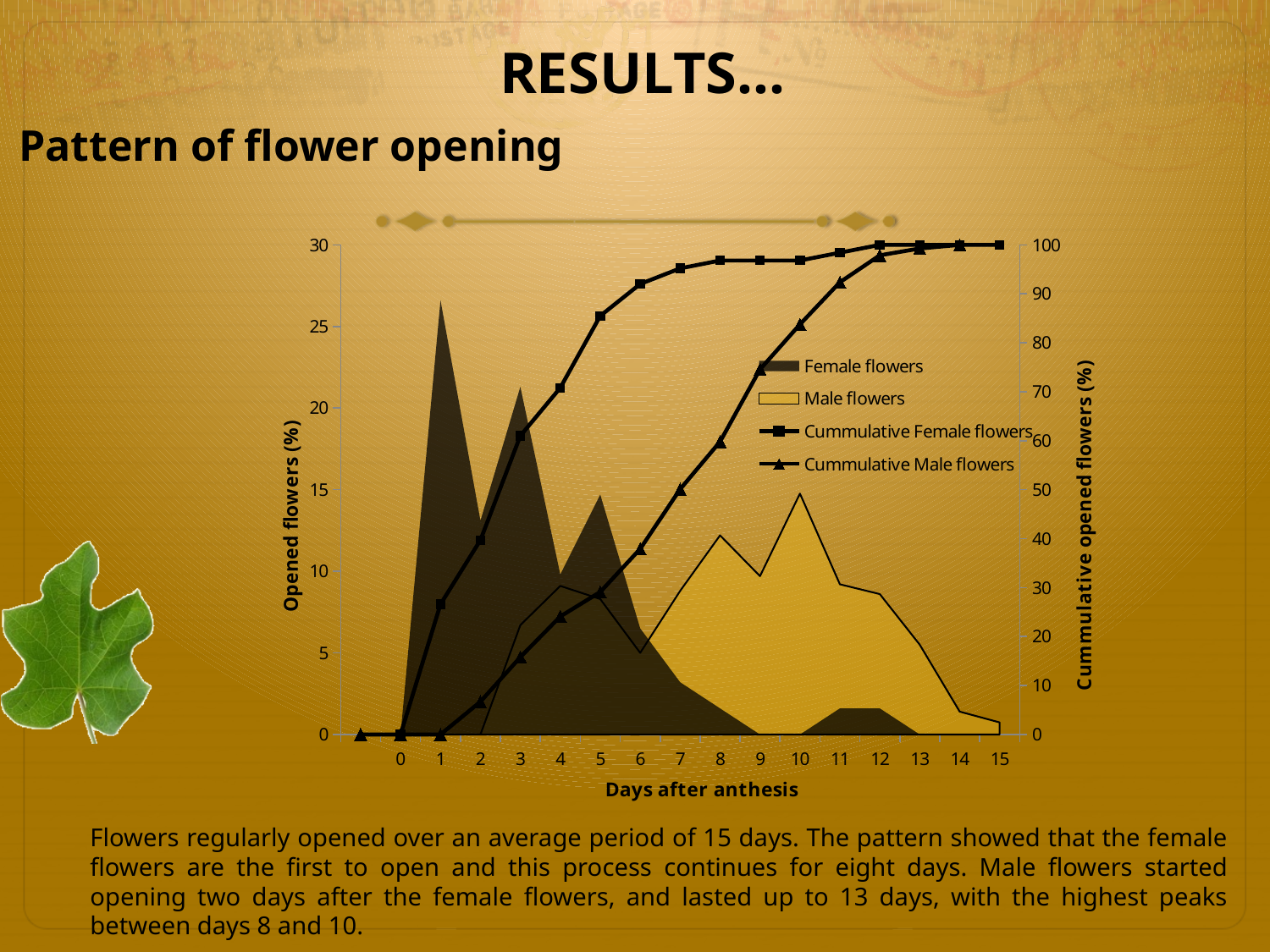
What is the title of the left vertical axis of the chart? Opened flowers (%) At day 5, which is larger: Cummulative Female flowers or Cummulative Male flowers? Cummulative Female flowers On which day after anthesis does the Male flowers series reach its highest value? 10 What is the title of the x axis of the chart? Days after anthesis Is the value for Cummulative Female flowers at day 7 greater or less than 90? greater Is the value for Cummulative Male flowers at day 3 greater or less than 20? less How many series does the chart legend list? 4 Is the value for Female flowers at day 1 greater or less than 25? greater How many day values are labelled on the x axis of the chart? 16 On which day after anthesis does the Female flowers series reach its highest value? 1 Does the Cummulative Male flowers series rise or fall as days after anthesis increase? rise